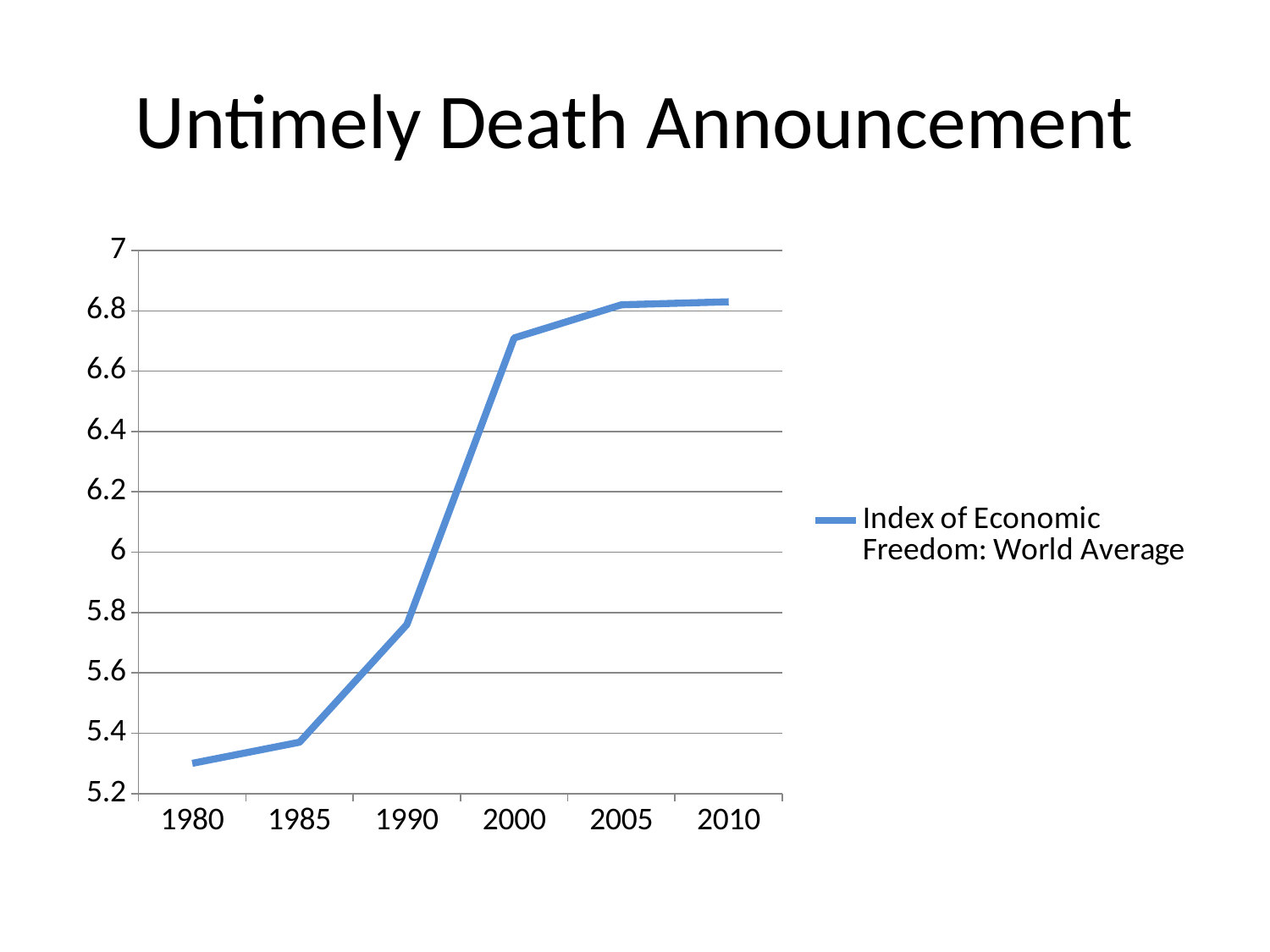
What is the name of the series shown in the legend? Index of Economic Freedom: World Average Is the value for 2000 greater or less than 6.6? greater What kind of chart is shown on the slide? line chart Do the values rise or fall from 1980 to 2010? rise Is the value for 1990 greater or less than 5.6? greater Which year has the larger value, 1990 or 2000? 2000 How many series does the legend list? 1 What is the title of the slide containing the chart? Untimely Death Announcement How many years are plotted along the x axis? 6 Which year has the lowest value for the Index of Economic Freedom: World Average? 1980 Is the value for 1980 greater or less than 5.4? less